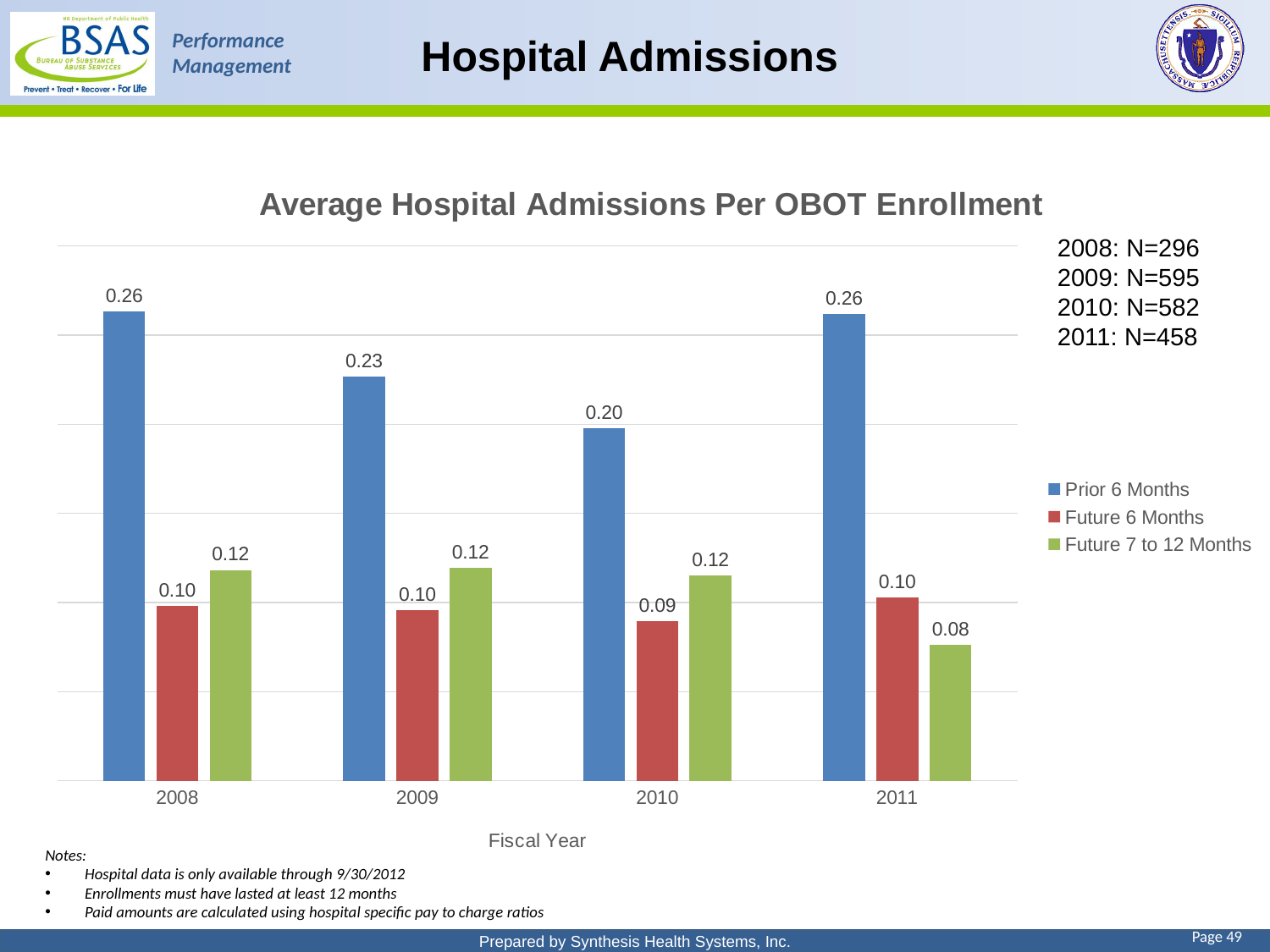
What is the value for Future 7 to 12 Months in fiscal year 2011? 0.08 How many fiscal years are shown on the x axis? 4 In which fiscal year is the Future 7 to 12 Months value lowest? 2011 How many series does the legend list? 3 What is the difference between the Prior 6 Months and Future 6 Months values in fiscal year 2008? 0.16 What kind of chart is shown on the slide? Bar chart What is the value for Future 6 Months in fiscal year 2010? 0.09 What is the title of the x axis? Fiscal Year Which is larger in fiscal year 2010: the Prior 6 Months value or the Future 7 to 12 Months value? Prior 6 Months Does the Prior 6 Months value rise or fall from fiscal year 2008 to 2010? Fall What is the value for Prior 6 Months in fiscal year 2009? 0.23 In which fiscal year is the Prior 6 Months value lowest? 2010